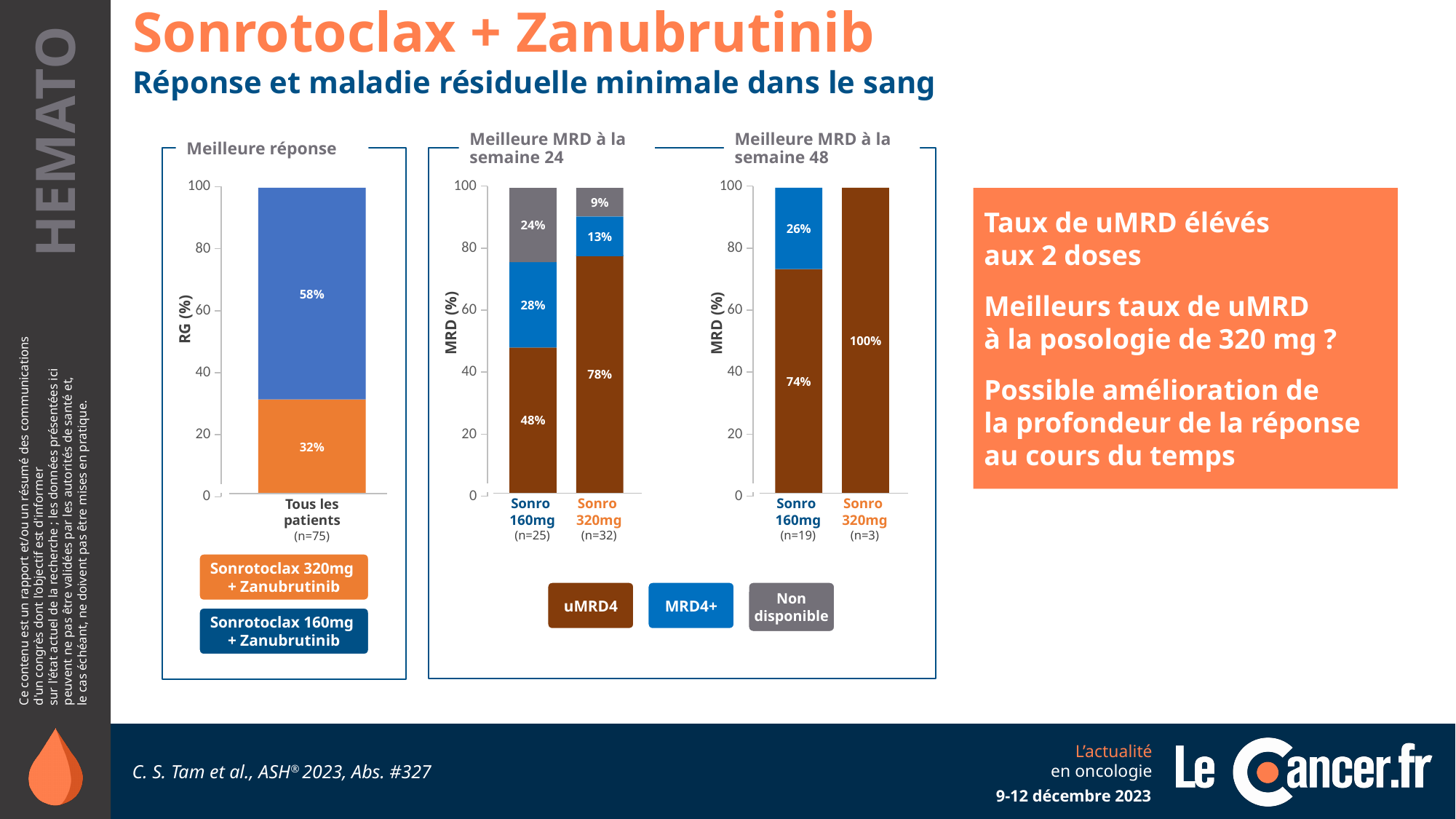
What kind of chart is the 'Meilleure réponse' chart? Stacked bar chart In the 'Meilleure MRD à la semaine 24' chart, what is the uMRD4 value for Sonro 160mg? 48% In the 'Meilleure MRD à la semaine 24' chart, what is the difference between the uMRD4 values for Sonro 320mg and Sonro 160mg? 30% In the 'Meilleure MRD à la semaine 48' chart, what is the MRD4+ value for Sonro 160mg? 26% In the 'Meilleure MRD à la semaine 48' chart, what is the uMRD4 value for Sonro 320mg? 100% In the 'Meilleure réponse' chart, what is the value of the orange segment for 'Tous les patients'? 32% How many categories are shown on the x axis of the 'Meilleure MRD à la semaine 24' chart? 2 In the 'Meilleure MRD à la semaine 24' chart, what is the 'Non disponible' value for Sonro 320mg? 9% How many series does the legend below the MRD charts list? 3 In the 'Meilleure MRD à la semaine 24' chart, what is the uMRD4 value for Sonro 320mg? 78% In the 'Meilleure MRD à la semaine 24' chart, what is the total of the stacked bar for Sonro 160mg? 100% In the 'Meilleure MRD à la semaine 48' chart, which dose has the higher uMRD4 value, Sonro 160mg or Sonro 320mg? Sonro 320mg